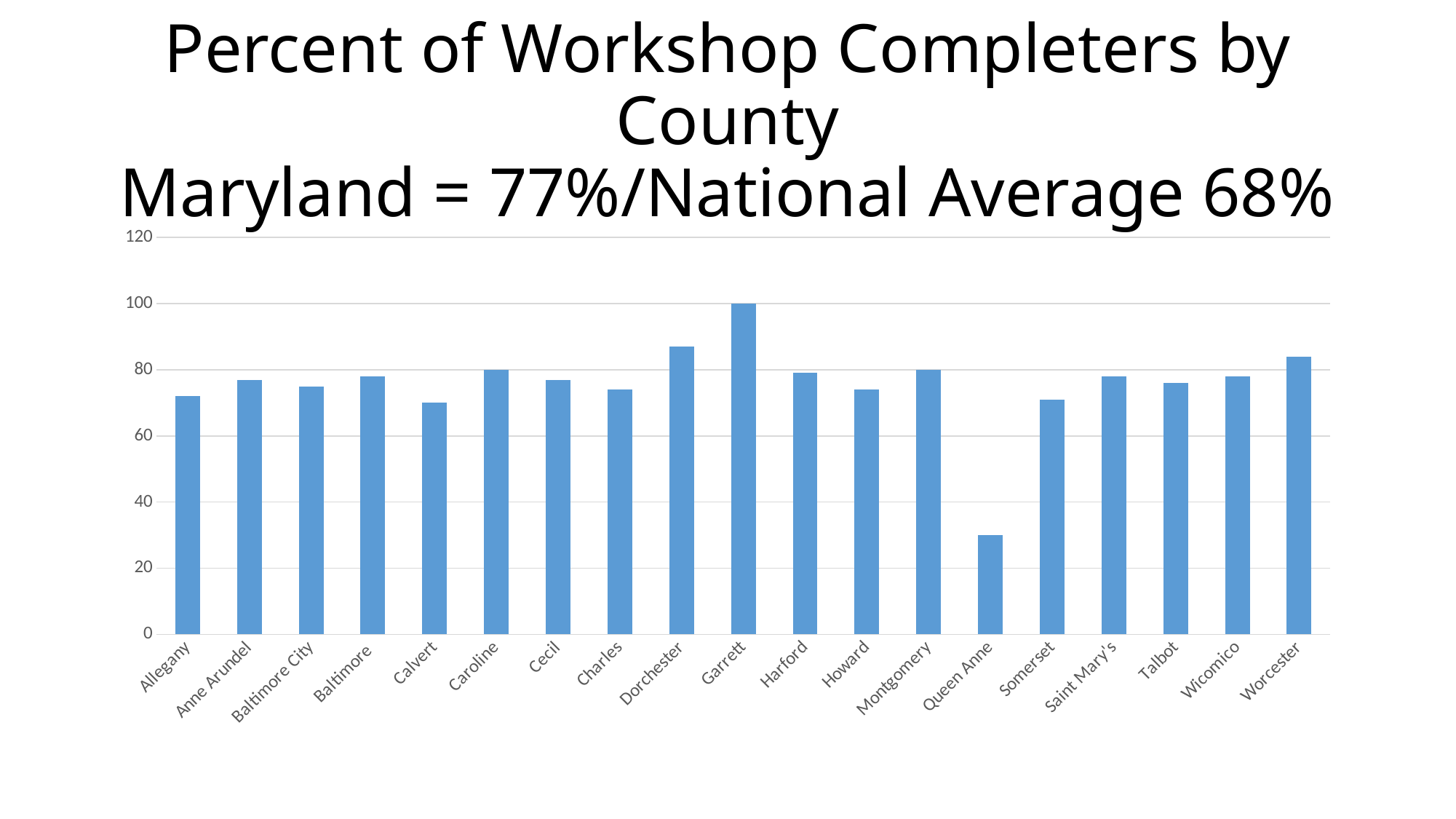
Is the value for Calvert greater or less than 60? greater Which county has the lowest percent of workshop completers? Queen Anne Which is larger, the value for Dorchester or the value for Howard? Dorchester What kind of chart is shown on the slide? bar chart Which is larger, the value for Queen Anne or the value for Somerset? Somerset Is the value for Queen Anne greater or less than 40? less How many counties are shown on the x axis? 19 Is the value for Dorchester greater or less than 80? greater Which county has the highest percent of workshop completers? Garrett What is the value for Garrett? 100 According to the chart title, what is the national average percent of workshop completers? 68%